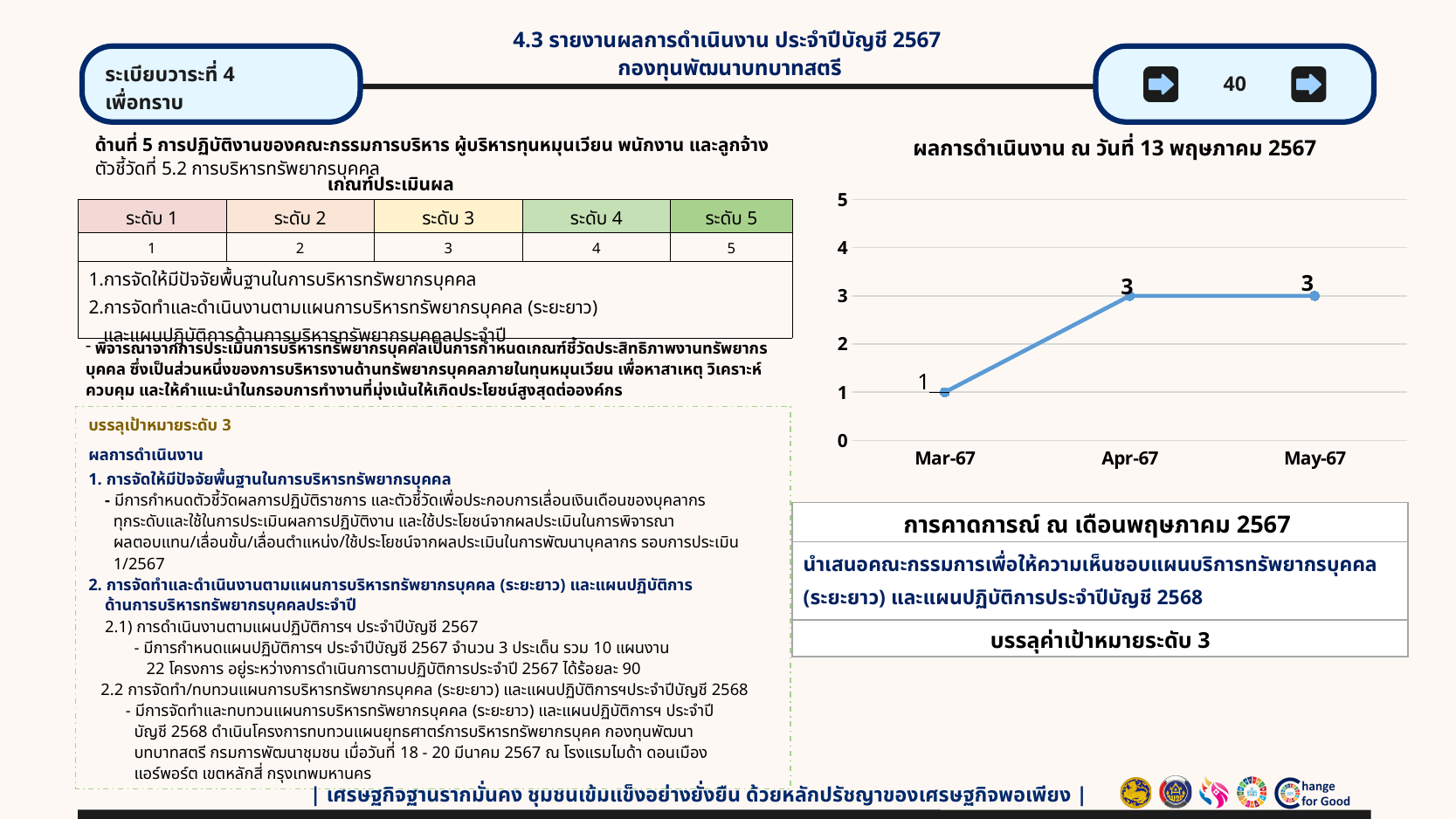
What kind of chart is shown on the slide? line chart Is the value for Mar-67 greater or less than 2? less What is the value for Apr-67? 3 How many data points are plotted on the chart? 3 What is the highest value shown on the y axis of the chart? 5 What is the value for May-67? 3 What is the value for Mar-67? 1 Is the value for May-67 greater or less than 2? greater Which is larger, the value for Mar-67 or the value for Apr-67? Apr-67 Do the values rise or fall from Mar-67 to Apr-67? rise What is the difference between the values for Apr-67 and Mar-67? 2 Which month has the lowest value? Mar-67